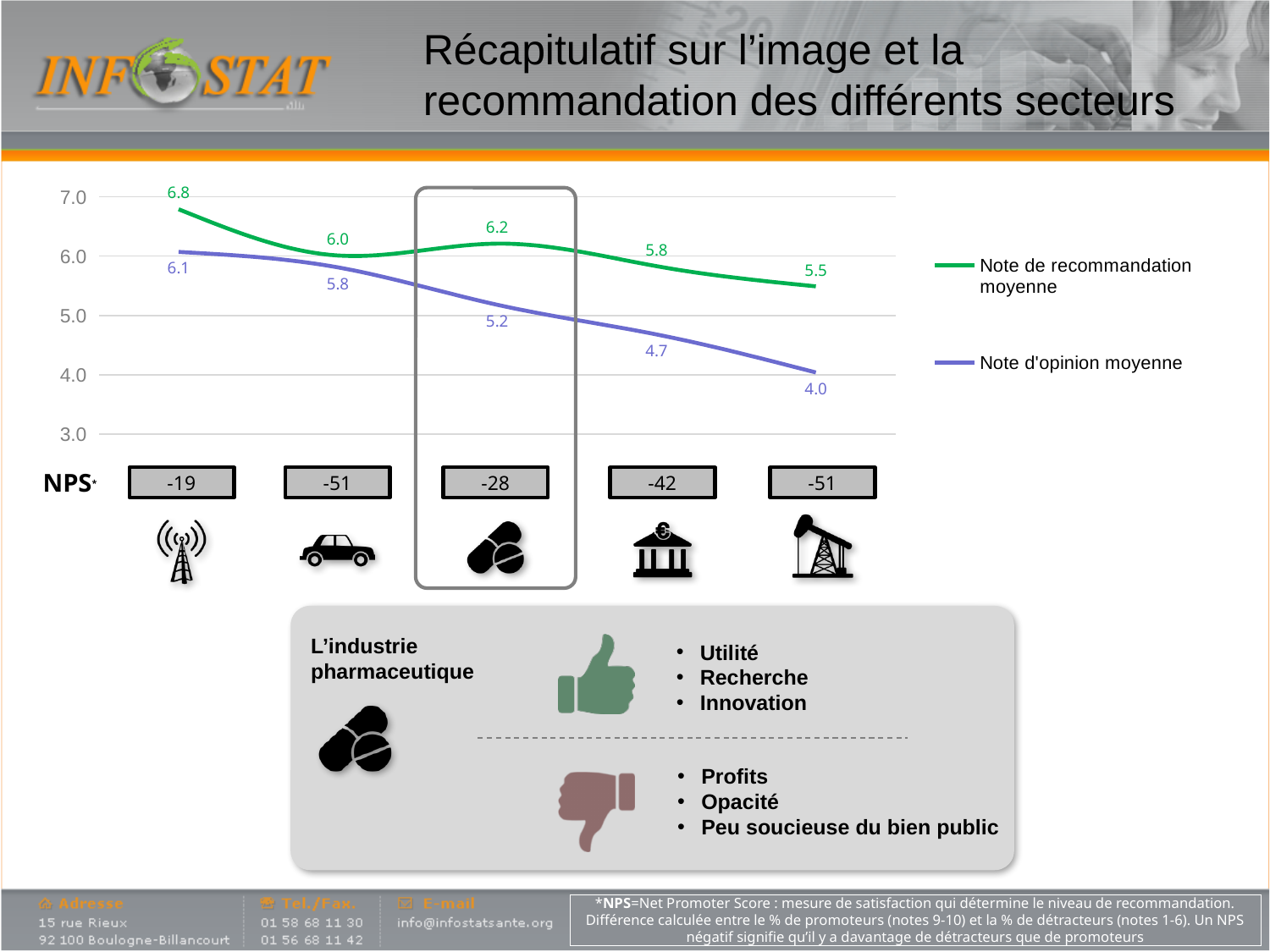
At the fourth point, which series has the higher value: 'Note de recommandation moyenne' or 'Note d'opinion moyenne'? Note de recommandation moyenne What are the two series names listed in the chart legend? Note de recommandation moyenne; Note d'opinion moyenne What is the value of 'Note d'opinion moyenne' at the last (rightmost) point? 4.0 What type of chart is shown on the slide? Line chart How many series does the chart legend list? 2 Does the 'Note d'opinion moyenne' line rise or fall from left to right? Fall At the highlighted third point, what is the difference between 'Note de recommandation moyenne' (6.2) and 'Note d'opinion moyenne' (5.2)? 1.0 What is the value of 'Note de recommandation moyenne' at the first (leftmost) point? 6.8 How many data points does each line in the chart have? 5 What is the lowest value on the 'Note d'opinion moyenne' line? 4.0 What is the highest value on the 'Note de recommandation moyenne' line? 6.8 What is the value of 'Note de recommandation moyenne' at the highlighted (third) point, the pharmaceutical industry? 6.2